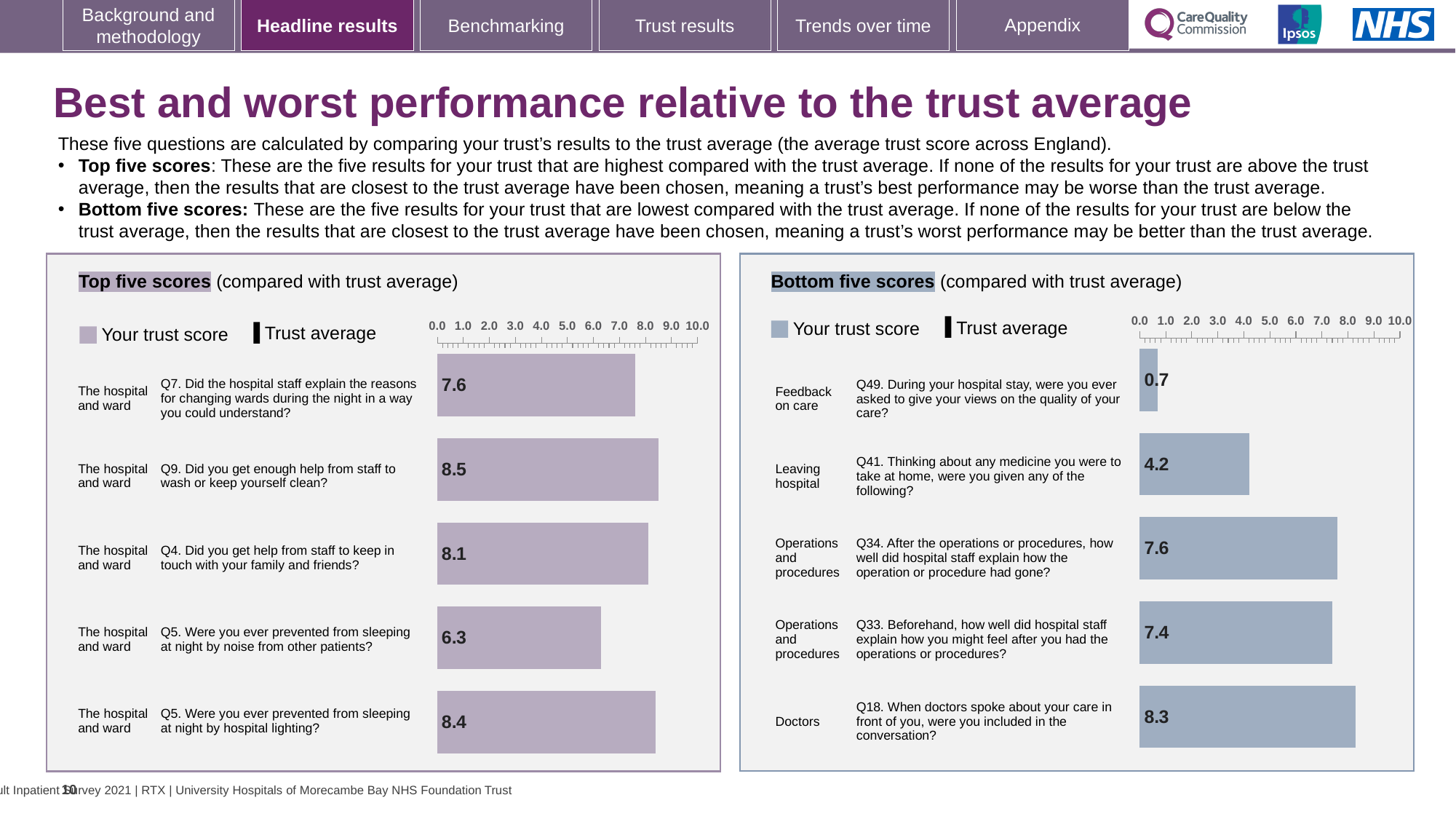
How many questions are plotted in the Top five scores chart? 5 In the Bottom five scores chart, what is the difference between the score for Q18 and the score for Q49? 7.6 In the Bottom five scores chart, what is the trust score for Q41 (Thinking about any medicine you were to take at home, were you given any of the following?)? 4.2 In the Top five scores chart, which question has the lowest trust score? Q5. Were you ever prevented from sleeping at night by noise from other patients? In the Bottom five scores chart, which has the larger trust score: Q34 or Q33? Q34 What type of chart is used in the Bottom five scores panel? Bar chart In the Top five scores chart, is the value for Q7 greater or less than 5.0? greater In the Bottom five scores chart, which question has the highest trust score? Q18. When doctors spoke about your care in front of you, were you included in the conversation? In the Bottom five scores chart, which question has the lowest trust score? Q49. During your hospital stay, were you ever asked to give your views on the quality of your care? In the Top five scores chart, what is the trust score for Q9 (Did you get enough help from staff to wash or keep yourself clean?)? 8.5 In the Top five scores chart, which question has the highest trust score? Q9. Did you get enough help from staff to wash or keep yourself clean? In the Top five scores chart, what is the difference between the score for Q9 (8.5) and the score for Q5 about noise from other patients (6.3)? 2.2